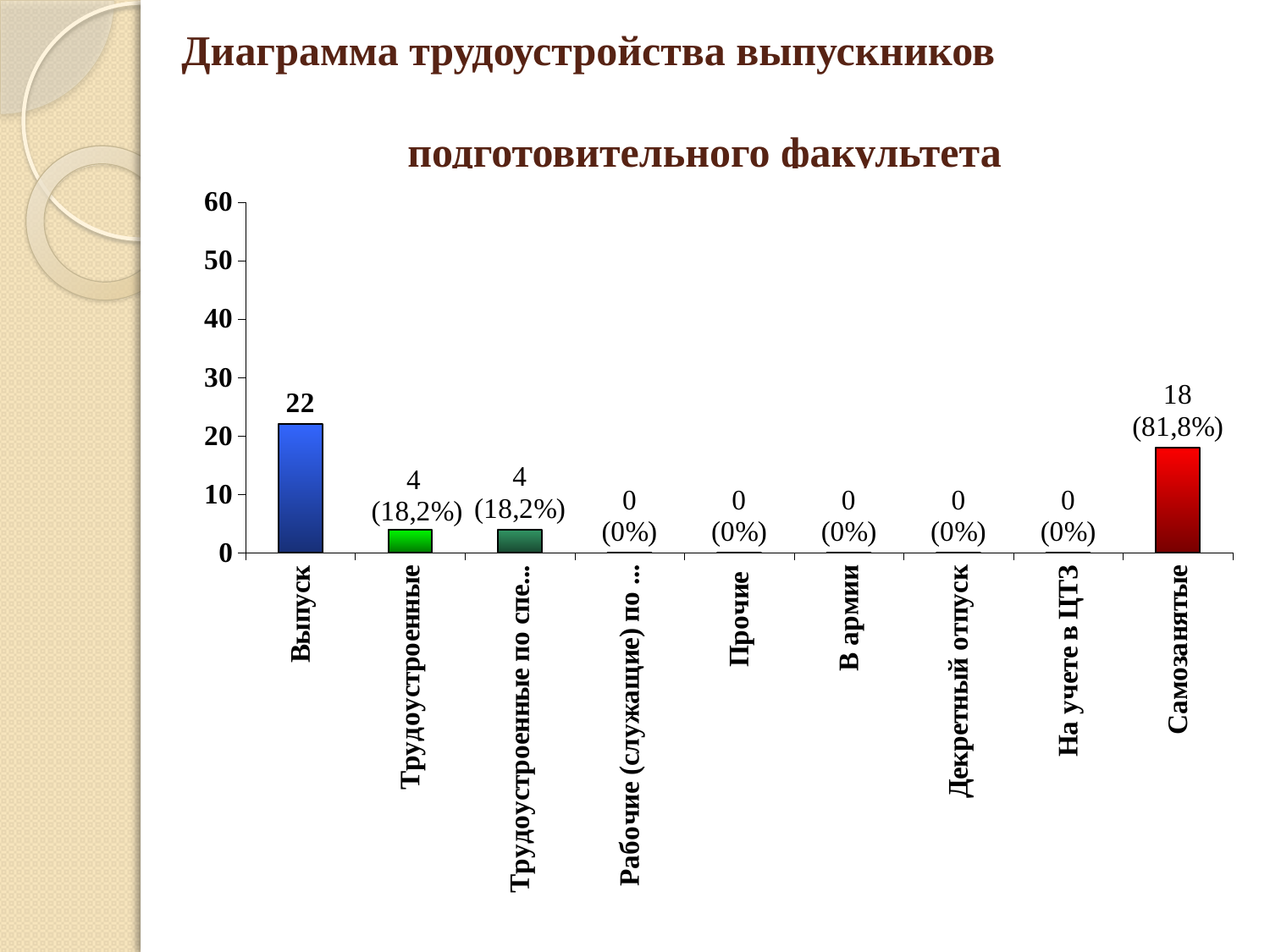
What is the value for В армии? 0 What is the value for Трудоустроенные? 4 How many categories have a value of 0? 5 Which category has the highest value? Выпуск What is the difference between the values for Выпуск and Самозанятые? 4 What percentage is shown for Трудоустроенные? 18,2% What is the value for Выпуск? 22 How many categories are shown on the x axis? 9 Which is larger, the value for Самозанятые or the value for Трудоустроенные? Самозанятые What is the value for Самозанятые? 18 What percentage is shown for Самозанятые? 81,8% What kind of chart is shown on the slide? Bar chart